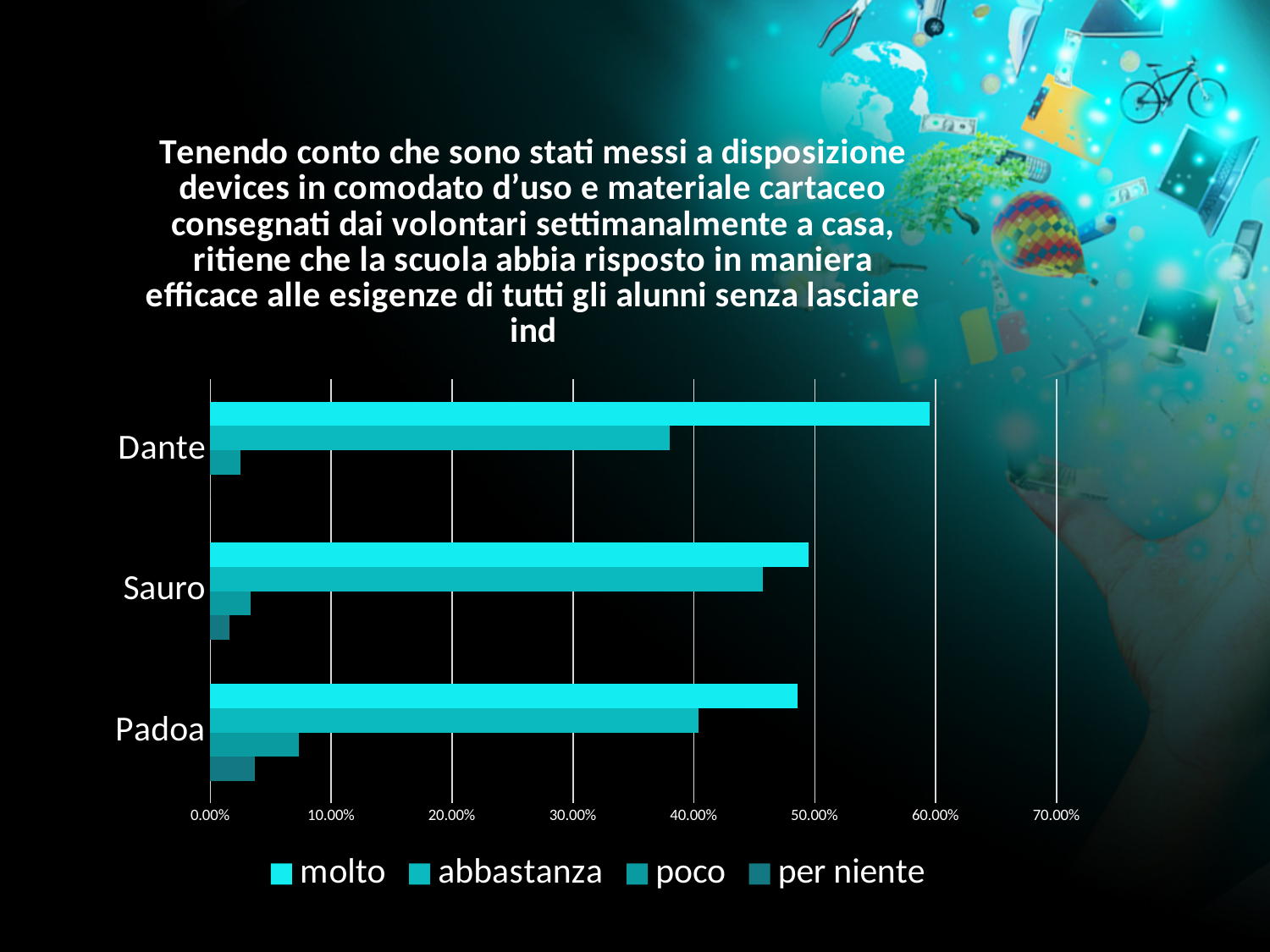
Is the "abbastanza" value for Sauro greater or less than 40.00%? greater Which school has the highest value for "molto"? Dante How many schools (categories) are shown on the chart? 3 Which school has the lowest value for "abbastanza"? Dante How many series does the chart legend list? 4 What are the four entries listed in the chart legend? molto, abbastanza, poco, per niente Which is larger: the "poco" value for Padoa or the "poco" value for Dante? Padoa Is the "molto" value for Dante greater or less than 50.00%? greater Is the "poco" value for Padoa greater or less than 10.00%? less What kind of chart is shown on the slide? bar chart Which is larger: the "molto" value for Dante or the "molto" value for Sauro? Dante